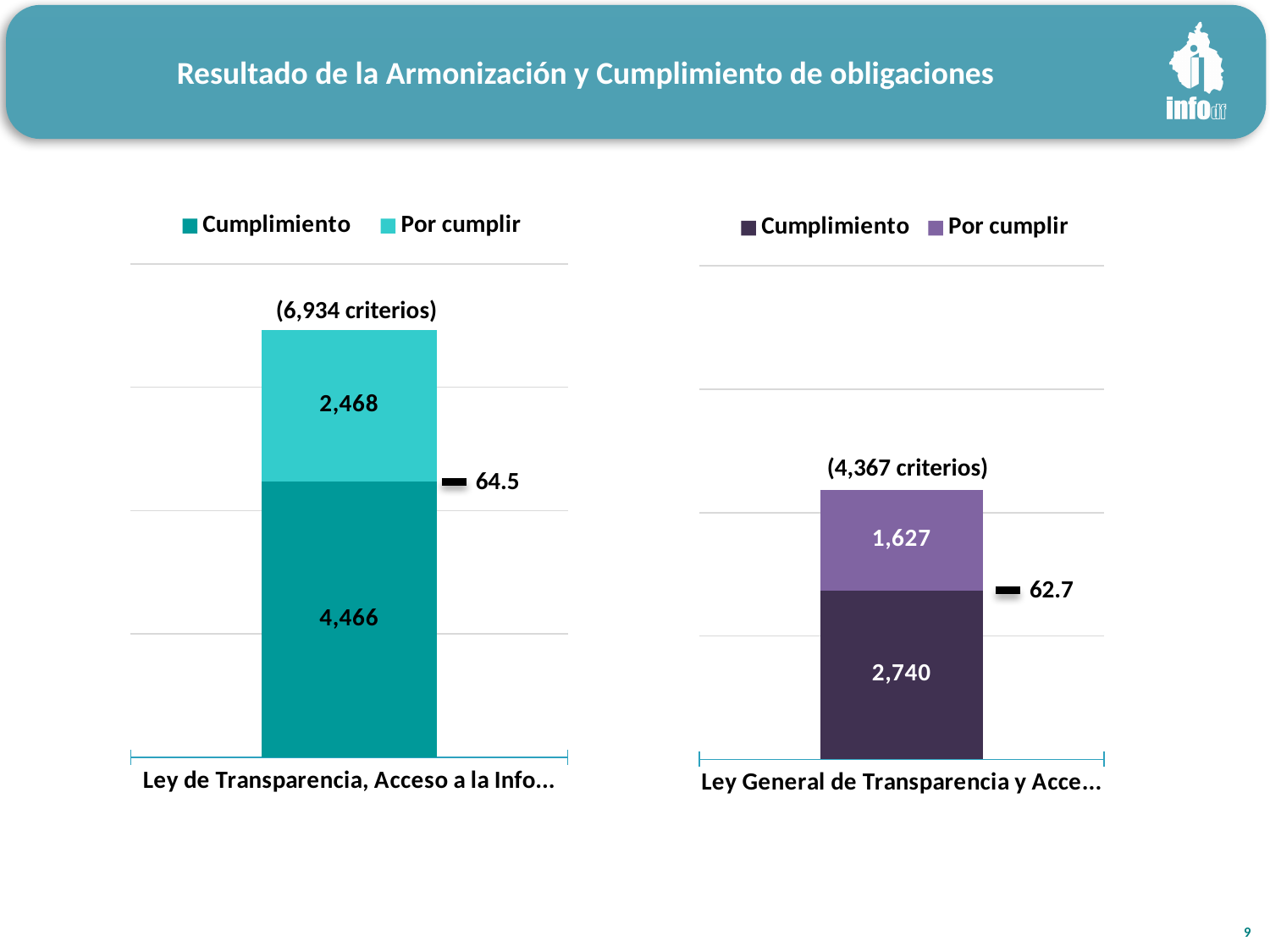
In the left chart, which is larger, Cumplimiento or Por cumplir? Cumplimiento In the left chart, what is the total of the stacked bar? 6,934 In the right chart, what value is shown next to the black marker beside the bar? 62.7 In the right chart, what is the value for Por cumplir? 1,627 In the right chart, what is the difference between Cumplimiento and Por cumplir? 1,113 In the left chart, what is the value for Cumplimiento? 4,466 In the right chart, what is the total of the stacked bar? 4,367 In the left chart, what is the difference between Cumplimiento and Por cumplir? 1,998 In the right chart, what is the value for Cumplimiento? 2,740 What kind of chart is the right chart? Stacked bar chart How many series does the legend of the left chart list? 2 In the left chart, what is the value for Por cumplir? 2,468